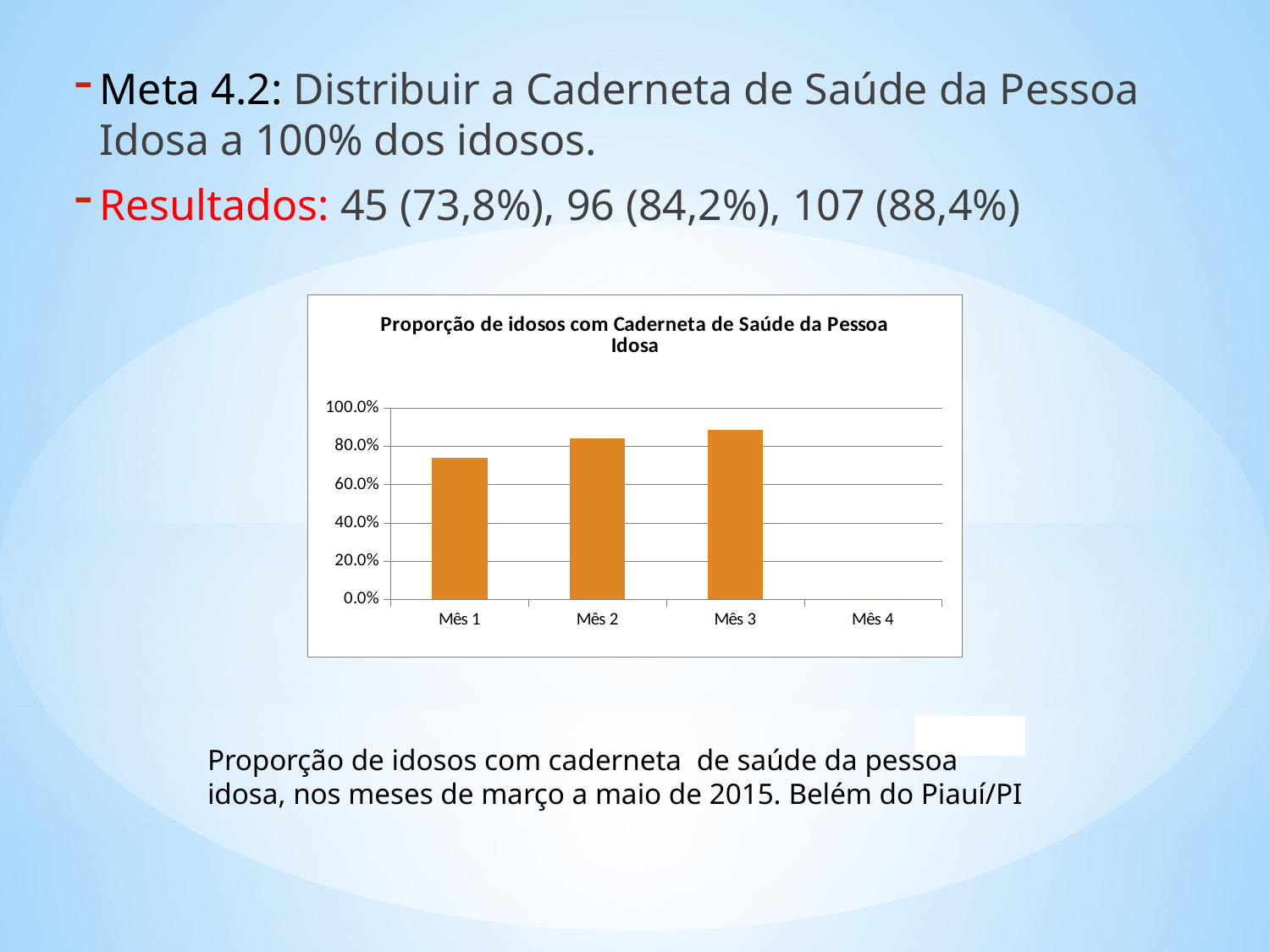
Is the value for Mês 3 greater or less than 100.0%? less What is the title of the chart? Proporção de idosos com Caderneta de Saúde da Pessoa Idosa Which month with a plotted bar has the lowest value? Mês 1 How many bars are plotted in the chart? 3 Which category on the x axis has no bar plotted? Mês 4 Do the bar values rise or fall from Mês 1 to Mês 3? rise Is the value for Mês 1 greater or less than 80.0%? less What kind of chart is shown on the slide? bar chart How many categories are labelled on the x axis of the chart? 4 Is the value for Mês 2 greater or less than 80.0%? greater Which is larger, the value for Mês 1 or the value for Mês 3? Mês 3 Which month has the highest bar in the chart? Mês 3